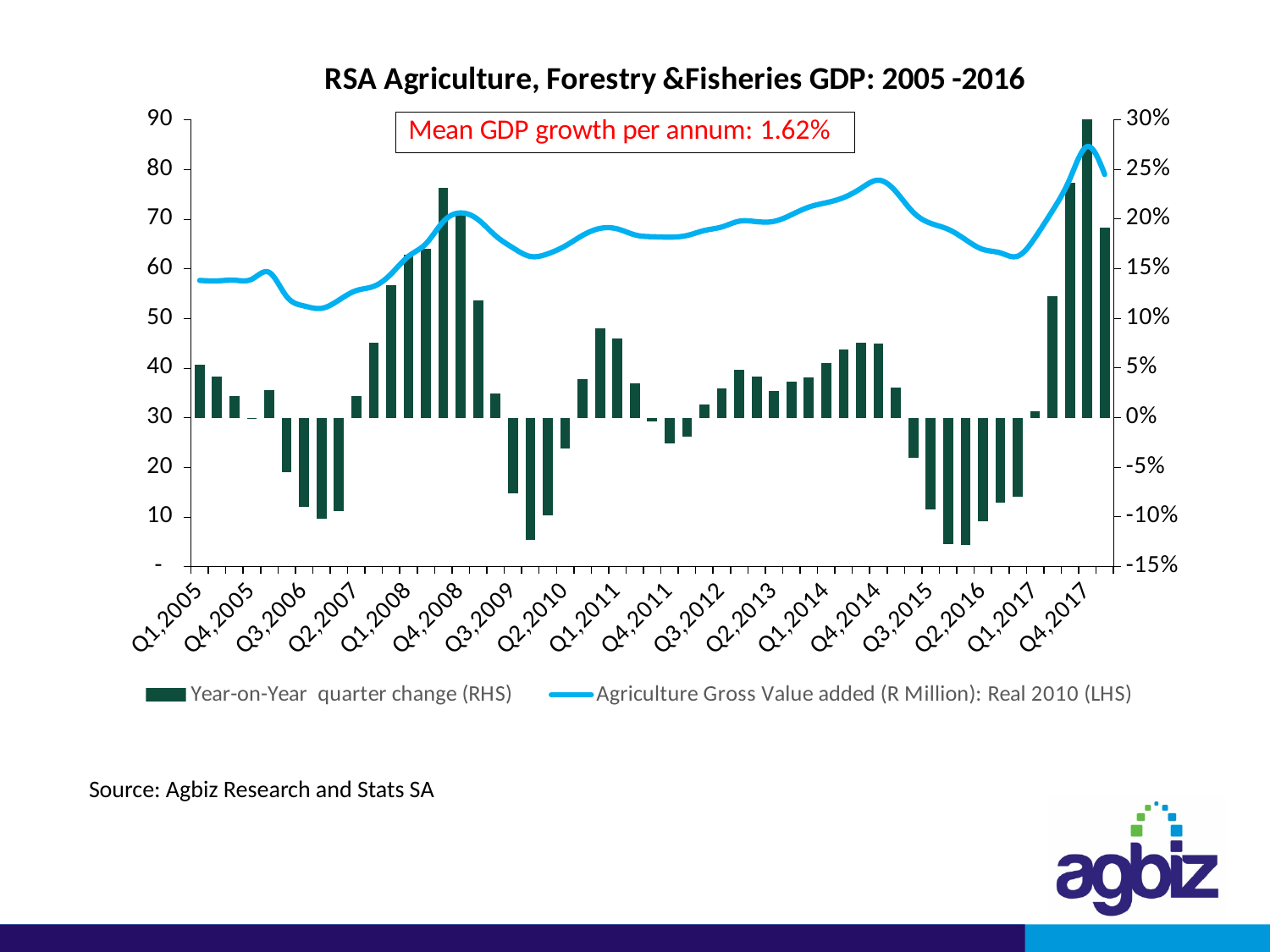
Which labelled quarter has the highest Year-on-Year quarter change bar? Q4,2017 Is the Agriculture Gross Value added line for Q4,2014 greater or less than 70 on the left-hand axis? greater How many series does the legend list? 2 Does the Agriculture Gross Value added line overall rise or fall from Q1,2005 to Q4,2017? rise Is the Agriculture Gross Value added line for Q2,2007 greater or less than 60 on the left-hand axis? less How many quarter labels are shown on the x axis? 18 Is the Year-on-Year quarter change for Q4,2008 greater or less than 15%? greater What type of chart is shown on the slide? Combination bar and line chart What is the title of the chart? RSA Agriculture, Forestry &Fisheries GDP: 2005 -2016 What mean GDP growth per annum is stated in the text box on the chart? 1.62%